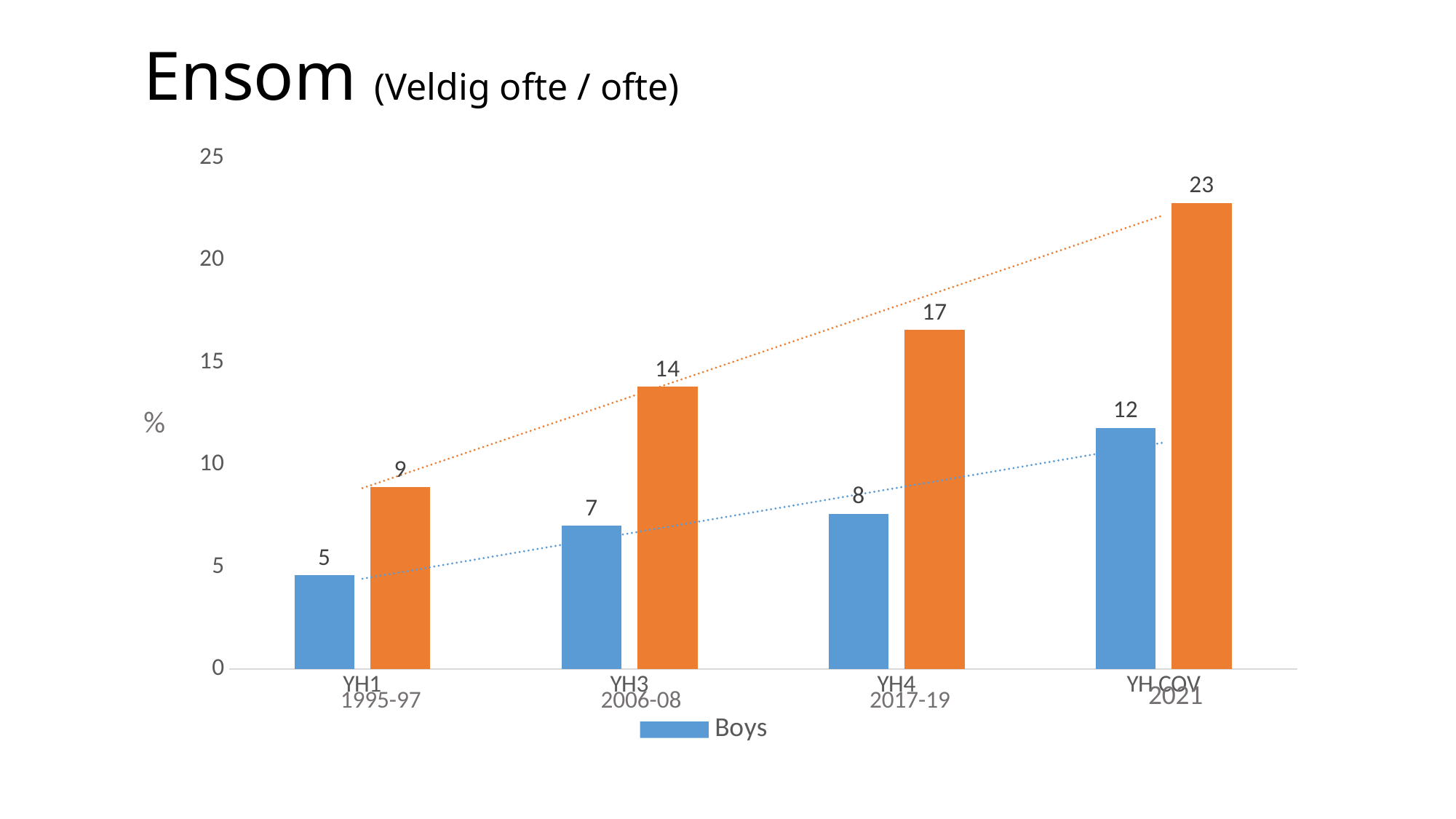
In which category is the value for Boys highest? YH COV 2021 How many categories are shown on the x axis? 4 How many series does the legend list? 1 What is the value for Boys in YH COV 2021? 12 Which is larger in YH3 2006-08: the Boys bar or the orange bar? the orange bar What is the value for Boys in YH1 1995-97? 5 Do the values for Boys rise or fall from YH1 1995-97 to YH COV 2021? rise What kind of chart is shown on the slide? bar chart What is the difference between the orange bar and the Boys bar in YH COV 2021? 11 In which category is the orange bar lowest? YH1 1995-97 What is the value of the orange bar for YH4 2017-19? 17 What is the value of the orange bar for YH3 2006-08? 14